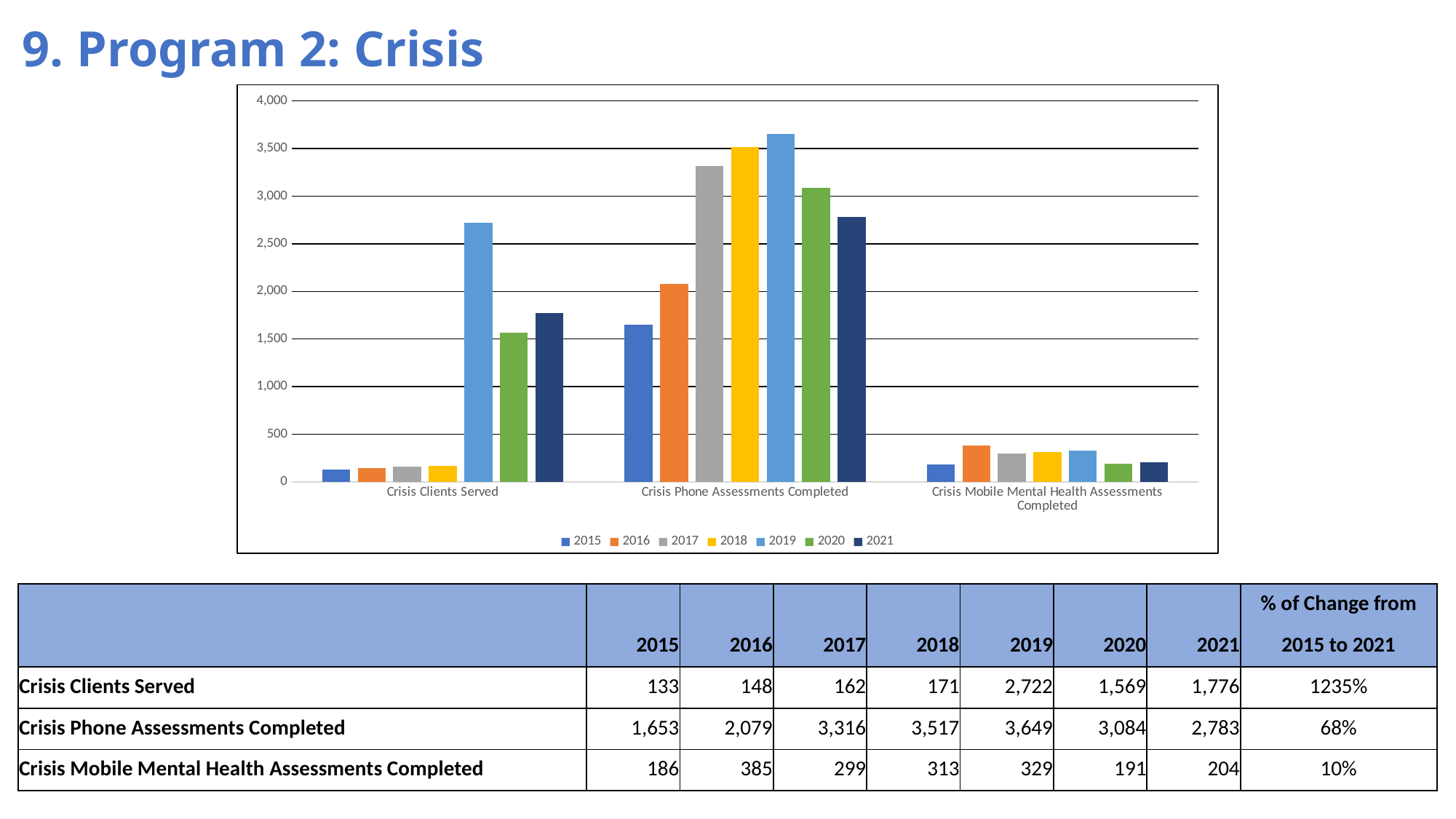
What is the value for Crisis Phone Assessments Completed in 2021? 2,783 How many categories are shown on the x axis of the chart? 3 What kind of chart is shown on the slide? bar chart What is the value for Crisis Mobile Mental Health Assessments Completed in 2016? 385 Which is larger: the 2017 value for Crisis Phone Assessments Completed or the 2020 value? 2017 What is the percentage change from 2015 to 2021 for Crisis Clients Served? 1235% How many series does the chart legend list? 7 Which year has the lowest value for Crisis Clients Served? 2015 Which year has the highest value for Crisis Phone Assessments Completed? 2019 Is the value for Crisis Phone Assessments Completed in 2016 greater or less than 2,000? greater What is the difference between the 2019 and 2020 values for Crisis Clients Served? 1,153 What is the value for Crisis Clients Served in 2019? 2,722